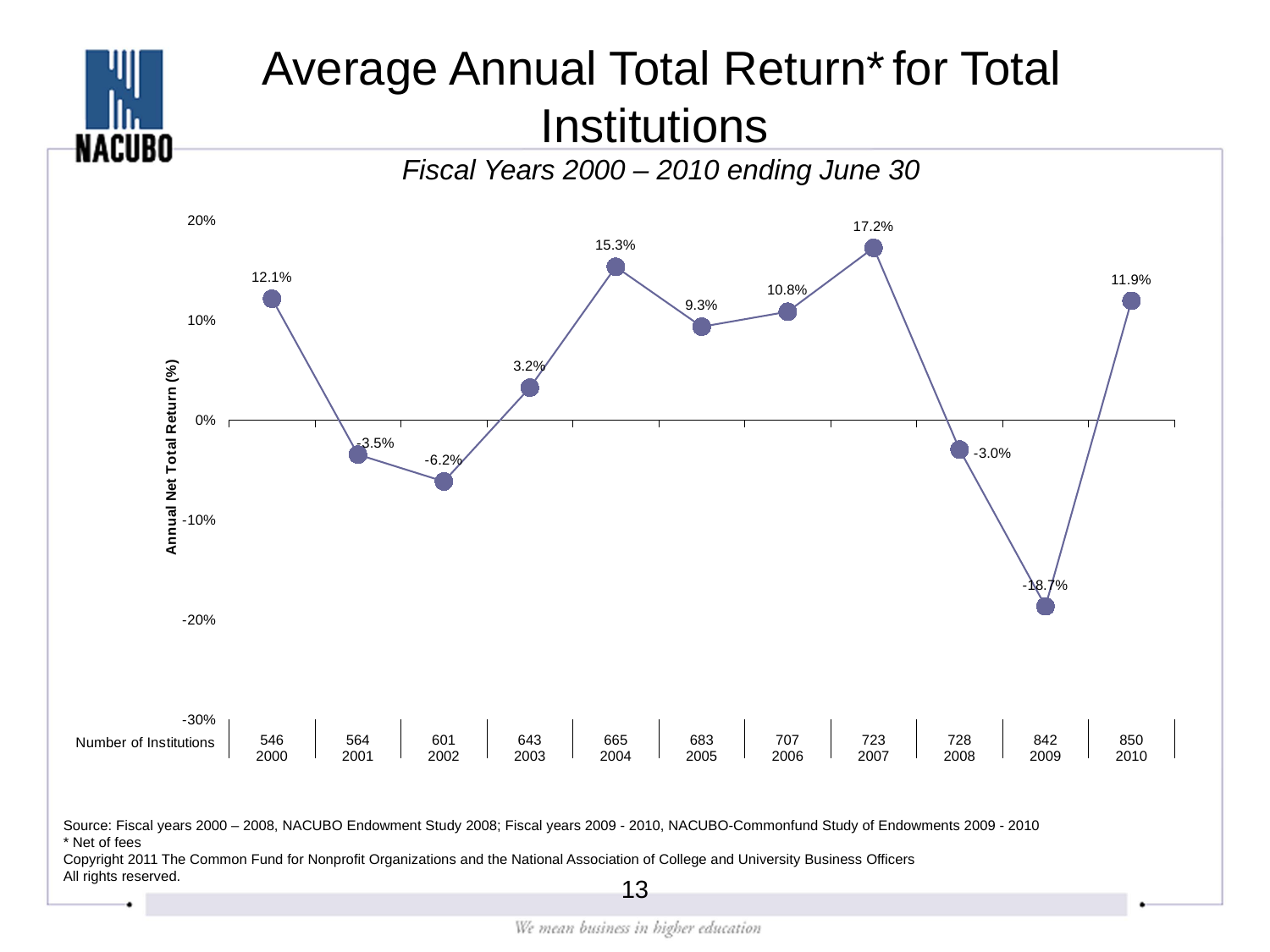
What was the average annual total return in fiscal year 2003? 3.2% What was the average annual total return in fiscal year 2007? 17.2% What kind of chart is shown on the slide? Line chart What is the label on the vertical axis of the chart? Annual Net Total Return (%) Which year had a higher return, 2004 or 2010? 2004 How many institutions were included in fiscal year 2010? 850 Which fiscal year had the lowest average annual total return? 2009 What was the average annual total return in fiscal year 2009? -18.7% How many fiscal years are plotted on the chart? 11 Which fiscal year had the highest average annual total return? 2007 What is the difference between the return in 2007 and the return in 2008? 20.2 percentage points Did the average annual total return rise or fall from 2008 to 2009? Fall